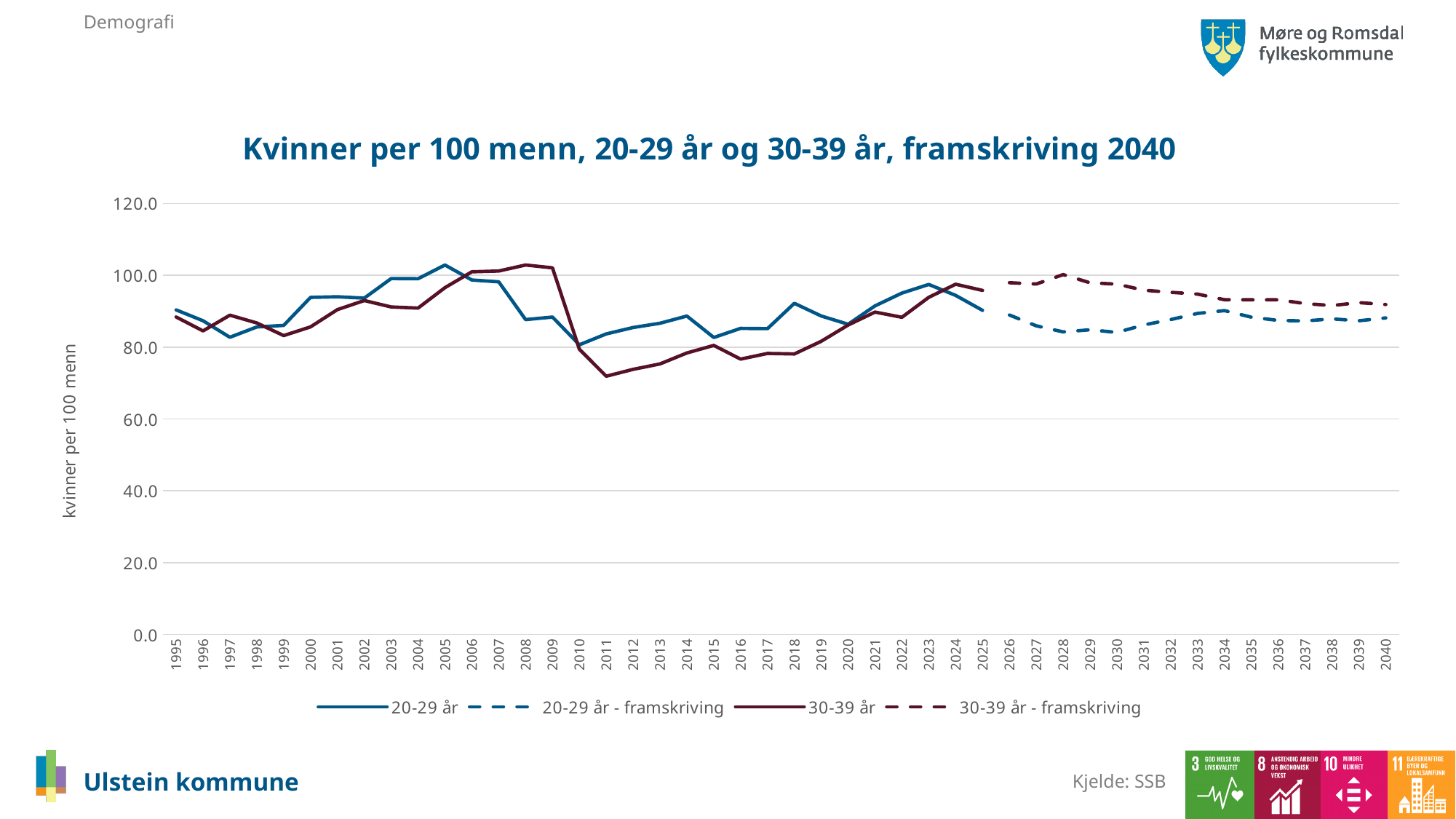
What is the title of the chart? Kvinner per 100 menn, 20-29 år og 30-39 år, framskriving 2040 How many series does the legend list? 4 What is the label on the vertical axis? kvinner per 100 menn Is the value for 30-39 år in 2008 greater or less than 100? greater What kind of chart is shown on the slide? line chart Is the value for 20-29 år in 2005 greater or less than 100? greater Is the value for 30-39 år in 2011 greater or less than 80? less Does the 20-29 år line rise or fall between 2005 and 2010? fall In 2011, which series has the higher value, 20-29 år or 30-39 år? 20-29 år Does the 30-39 år line rise or fall between 2011 and 2024? rise In 2008, which series has the higher value, 20-29 år or 30-39 år? 30-39 år